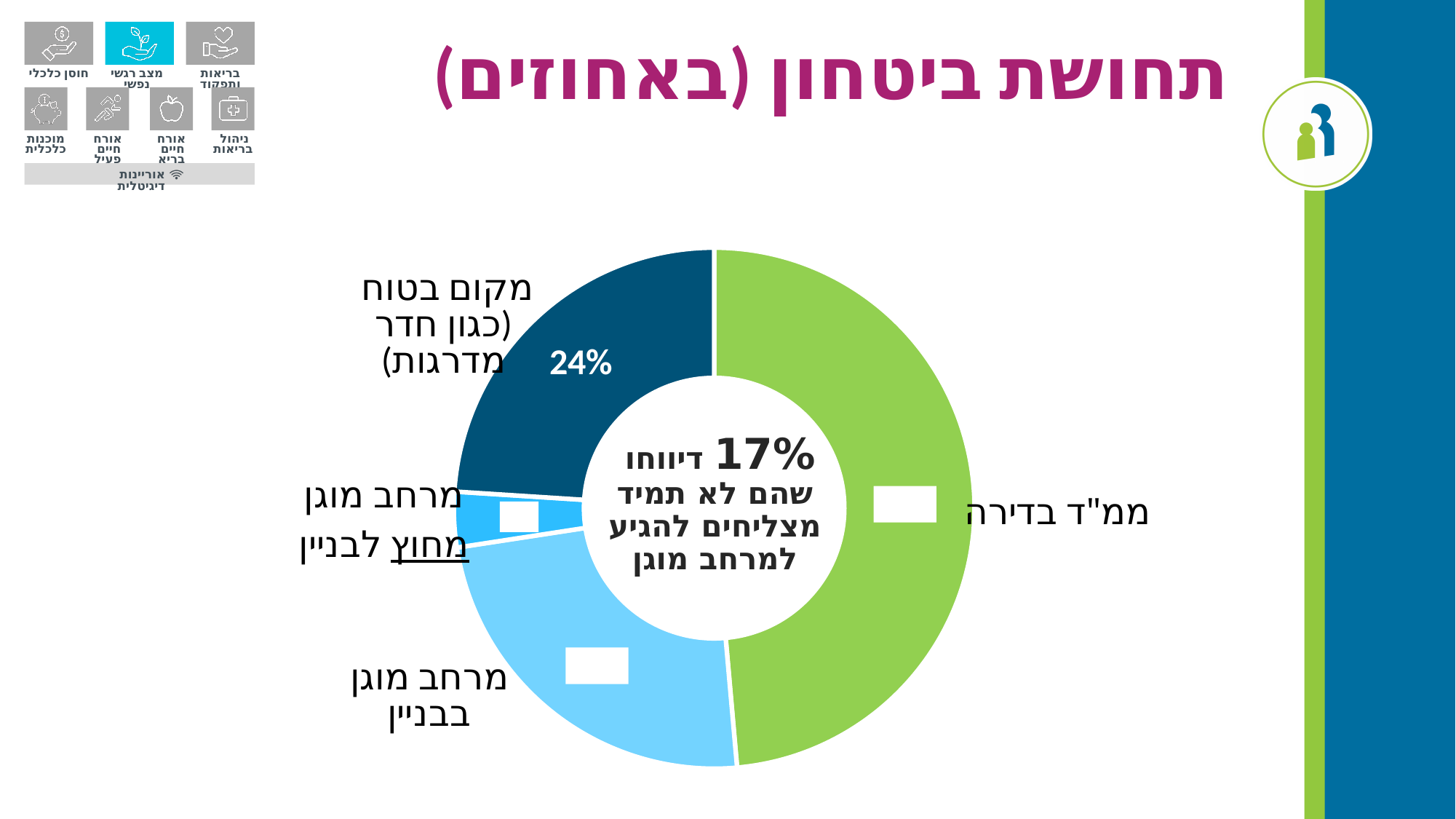
How many categories (slices) does the chart have? 4 Which slice is larger: ממ"ד בדירה or מרחב מוגן בבניין? ממ"ד בדירה What kind of chart is shown on the slide? Pie (donut) chart Which slice is larger: מקום בטוח (כגון חדר מדרגות) or מרחב מוגן מחוץ לבניין? מקום בטוח (כגון חדר מדרגות) What percentage is shown for the slice labelled מקום בטוח (כגון חדר מדרגות)? 24% Which category has the largest slice of the pie? ממ"ד בדירה What is the title of the chart on the slide? תחושת ביטחון (באחוזים) According to the text in the centre of the donut, what percentage reported they do not always manage to reach a protected space? 17% Which category has the smallest slice of the pie? מרחב מוגן מחוץ לבניין What share of the pie does the מקום בטוח (כגון חדר מדרגות) slice represent? 24%